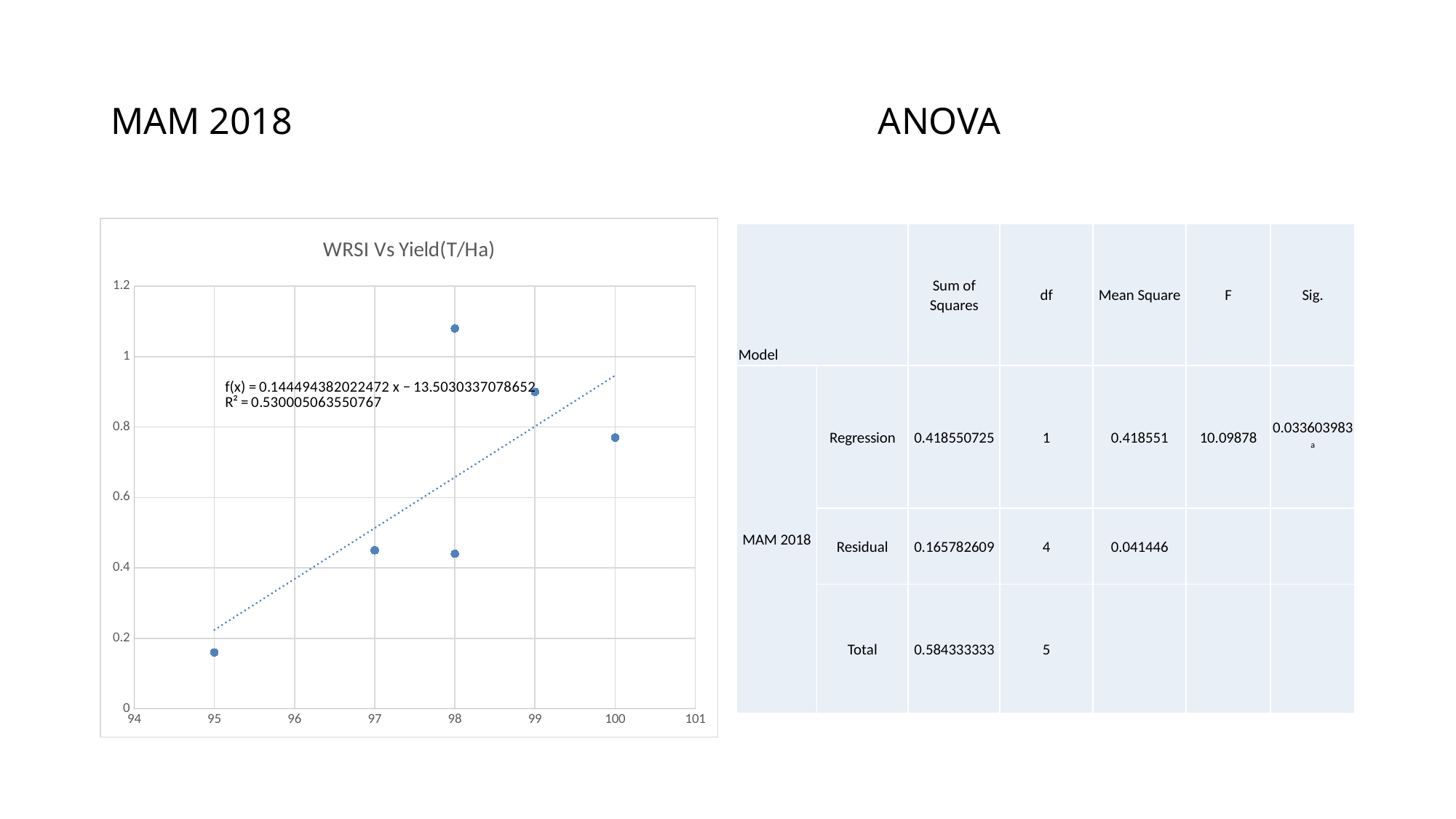
What kind of chart is shown on the slide? scatter chart Does the trendline rise or fall as WRSI increases along the x axis? rises At which WRSI value is the highest yield point plotted? 98 How many data points are plotted at WRSI 98? 2 What is the title of the chart? WRSI Vs Yield(T/Ha) How many data points are plotted in the chart? 6 Is the yield value for the point at WRSI 99 greater or less than 0.8? greater Is the yield value for the point at WRSI 100 greater or less than 0.6? greater At which WRSI value is the lowest yield point plotted? 95 What R² value is printed on the chart? R² = 0.530005063550767 Is the yield value for the highest point at WRSI 98 greater or less than 1? greater